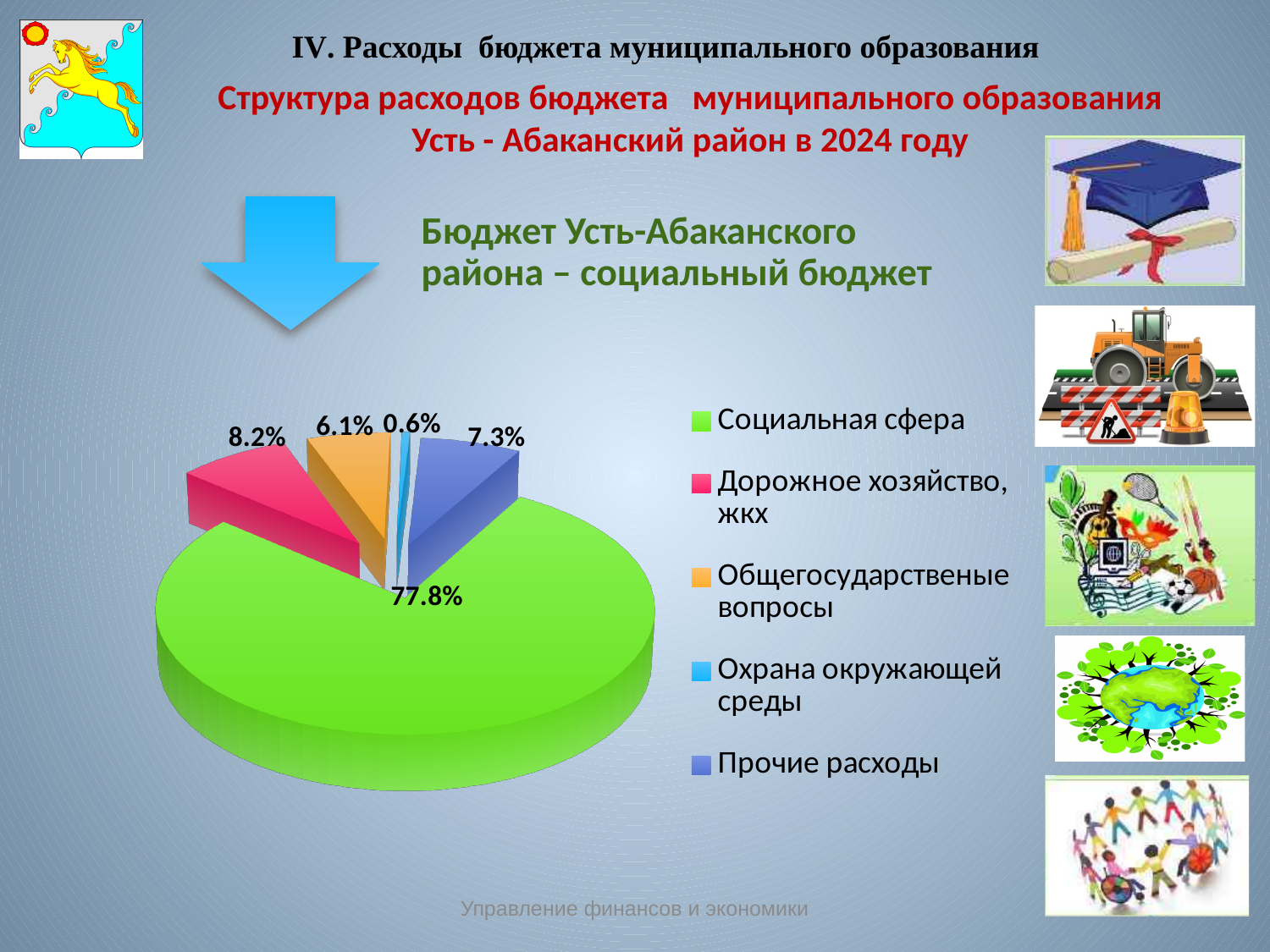
Сколько категорий показано на круговой диаграмме? 5 Какая доля расходов приходится на «Прочие расходы»? 7.3% Какая доля расходов приходится на «Общегосударственые вопросы»? 6.1% Какая доля расходов приходится на «Социальная сфера»? 77.8% Какая доля расходов приходится на «Охрана окружающей среды»? 0.6% Какая доля расходов приходится на «Дорожное хозяйство, жкх»? 8.2% Какая категория имеет наибольшую долю в структуре расходов? Социальная сфера Какой тип диаграммы показан на слайде? Круговая диаграмма Каким цветом на диаграмме обозначена категория «Социальная сфера»? Зелёным На сколько процентных пунктов доля «Дорожное хозяйство, жкх» больше доли «Прочие расходы»? 0.9 Что больше: доля «Общегосударственые вопросы» или доля «Прочие расходы»? Прочие расходы Какая категория имеет наименьшую долю в структуре расходов? Охрана окружающей среды